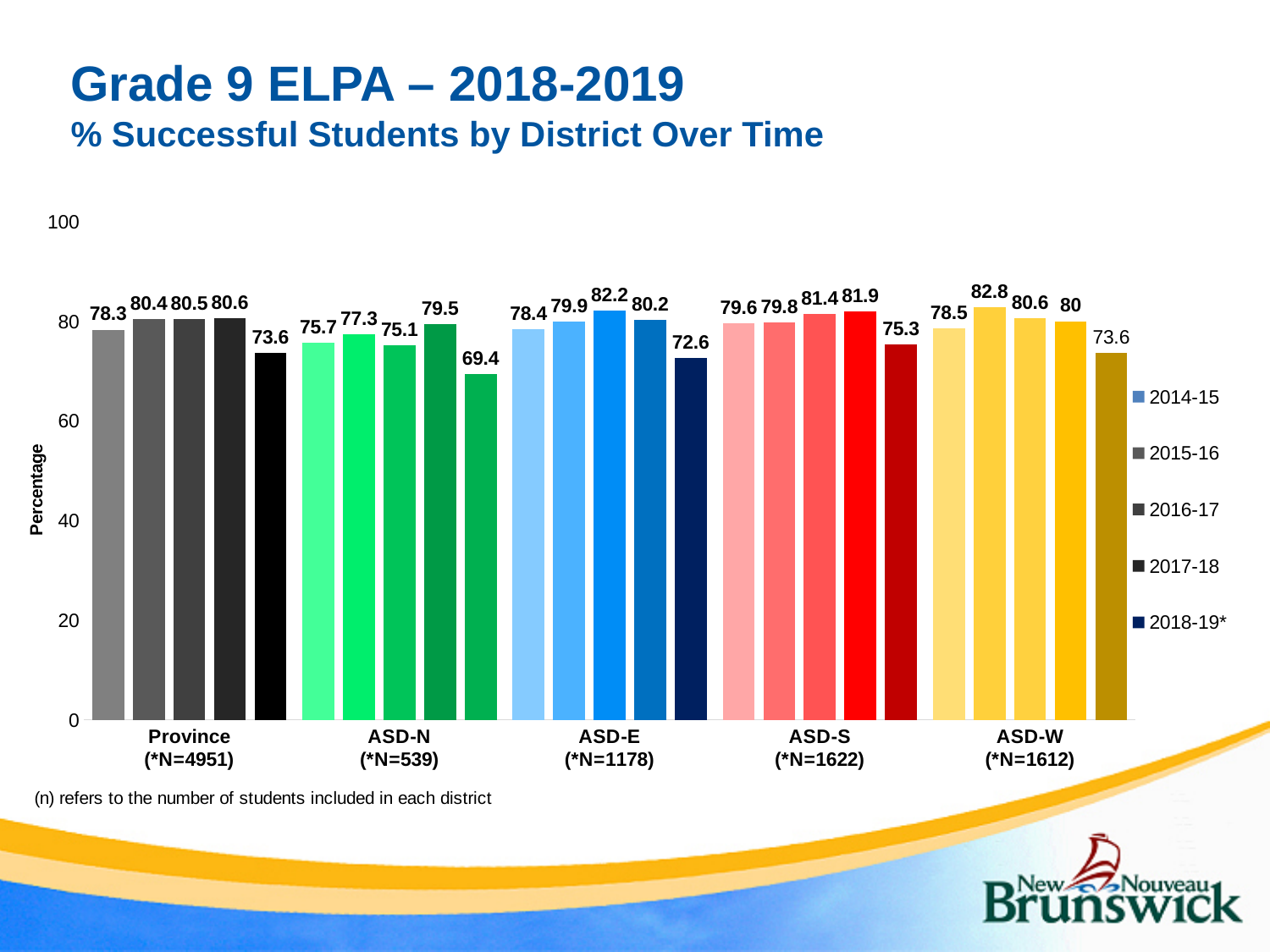
Which district has the lowest value in 2018-19*? ASD-N What is the number of students (N) shown for ASD-S? 1622 What is the value for ASD-E in 2016-17? 82.2 What is the value for Province in 2017-18? 80.6 Which district has the highest value in 2015-16? ASD-W Which is larger: the ASD-W value for 2014-15 or the ASD-S value for 2014-15? ASD-S value for 2014-15 What kind of chart is shown on the slide? Bar chart What is the value for ASD-N in 2018-19*? 69.4 How many districts (categories) are shown on the x axis? 5 How many series does the legend list? 5 Is the value for ASD-E in 2018-19* greater or less than 80? less What is the difference between the ASD-S values for 2017-18 and 2018-19*? 6.6